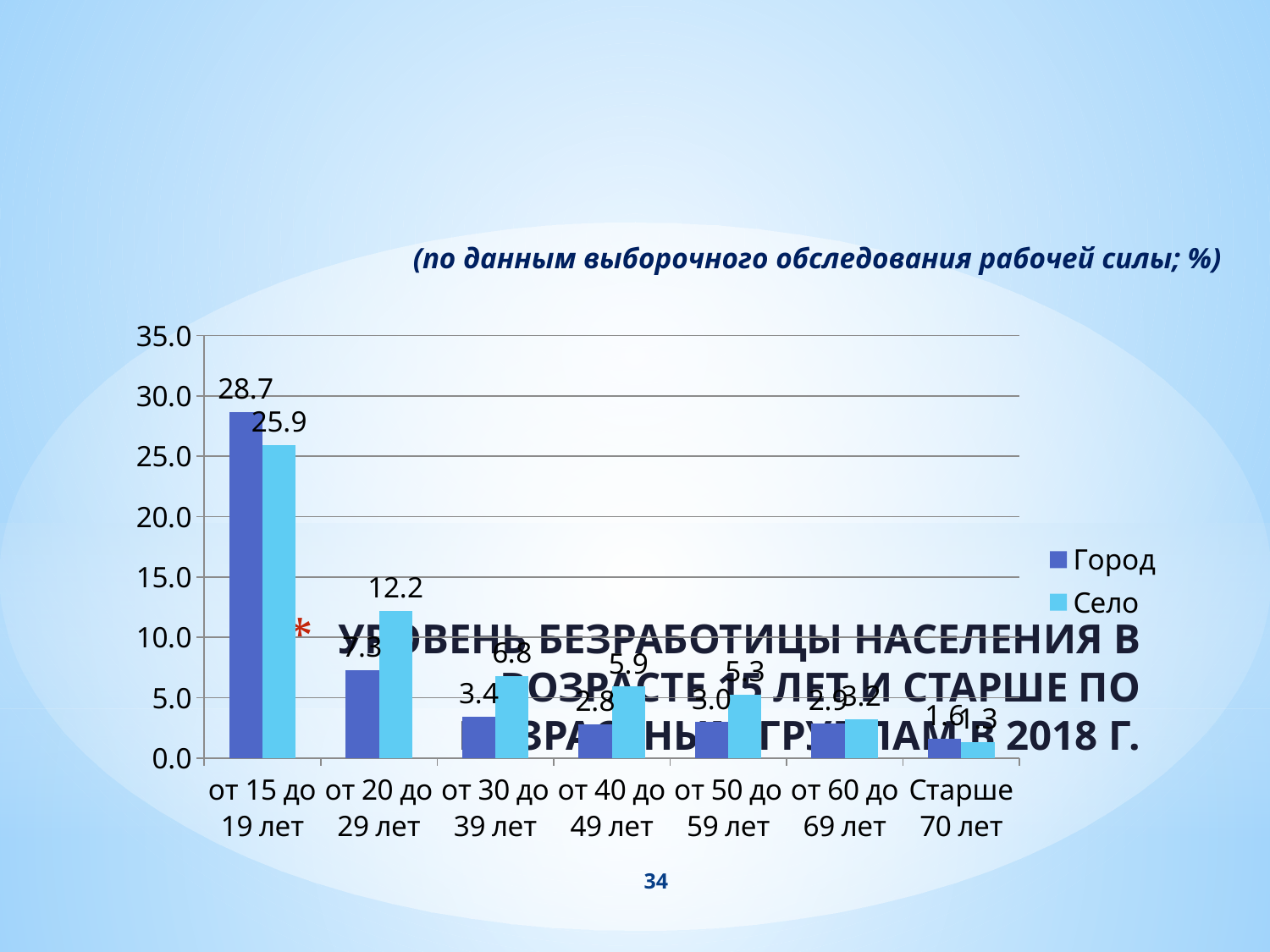
How many age groups are shown on the x axis? 7 What is the value for Село in the age group от 40 до 49 лет? 5.9 What is the difference between the Город and Село values in the age group от 15 до 19 лет? 2.8 Is the value for Село in the age group от 30 до 39 лет greater or less than 5.0? greater What is the value for Город in the age group от 30 до 39 лет? 3.4 How many series does the legend list? 2 Which age group has the highest value for Город? от 15 до 19 лет What is the value for Село in the age group от 20 до 29 лет? 12.2 What kind of chart is shown on the slide? bar chart What is the value for Село in the age group от 15 до 19 лет? 25.9 In the age group от 20 до 29 лет, which is larger: Город or Село? Село What is the value for Город in the age group от 15 до 19 лет? 28.7